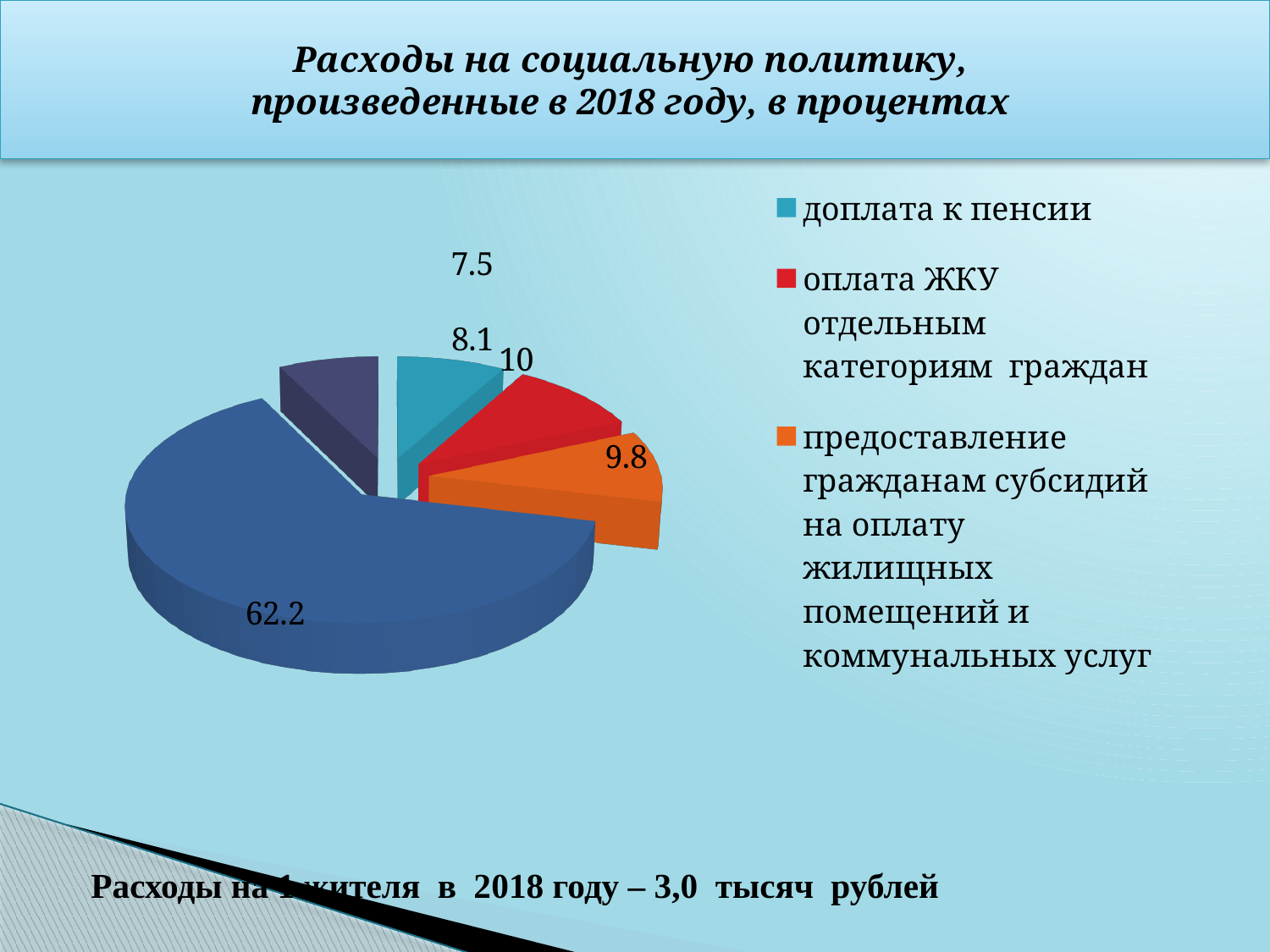
What is the smallest value labelled on the pie chart? 7.5 How many slices does the pie chart have? 5 What is the title of the slide? Расходы на социальную политику, произведенные в 2018 году, в процентах What is the value for доплата к пенсии? 8.1 What is the difference between the value for предоставление гражданам субсидий and the value for доплата к пенсии? 1.7 What is the largest value labelled on the pie chart? 62.2 How many entries are listed in the legend? 3 What is the value for оплата ЖКУ отдельным категориям граждан? 10 Which is larger, the value for оплата ЖКУ отдельным категориям граждан or the value for предоставление гражданам субсидий? оплата ЖКУ отдельным категориям граждан What is the value for предоставление гражданам субсидий на оплату жилищных помещений и коммунальных услуг? 9.8 What is the difference between the value for оплата ЖКУ отдельным категориям граждан and the value for доплата к пенсии? 1.9 What kind of chart is shown on the slide? pie chart